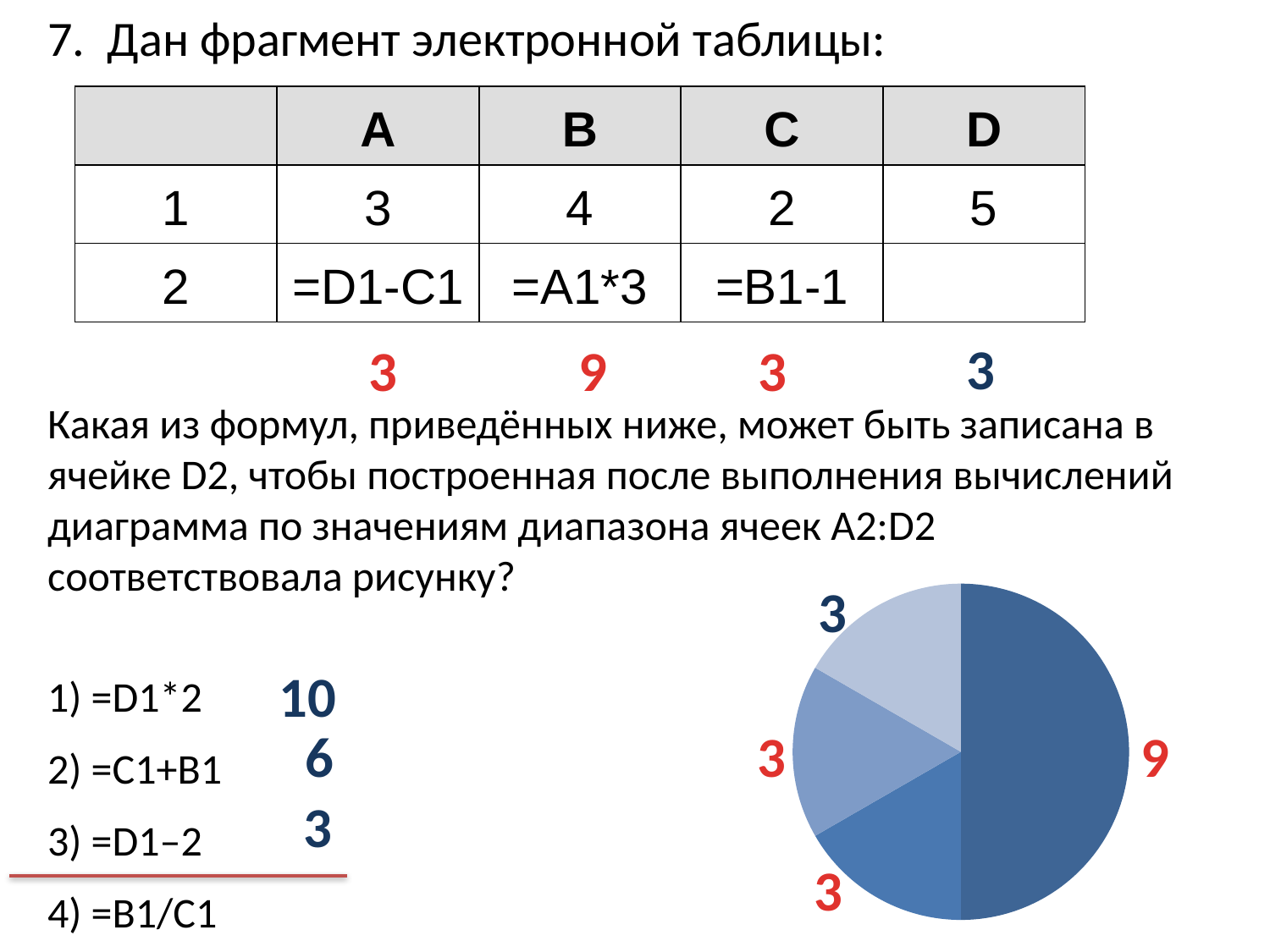
What is the value of the largest slice of the pie chart? 9 What is the value of the smallest slice of the pie chart? 3 What kind of chart is shown on the slide? pie chart What share of the pie does the slice labelled 9 take up? 50% What value is labelled on the dark blue slice on the right side of the pie? 9 What is the difference between the slice labelled 9 and a slice labelled 3? 6 What colour is the largest slice of the pie chart? dark blue What is the total of all the values labelled on the pie chart? 18 Does the pie chart have a legend? no How many slices of the pie chart are labelled 3? 3 How many slices does the pie chart have? 4 Which is larger: the dark blue slice on the right of the pie or the slice at the bottom? the dark blue slice on the right